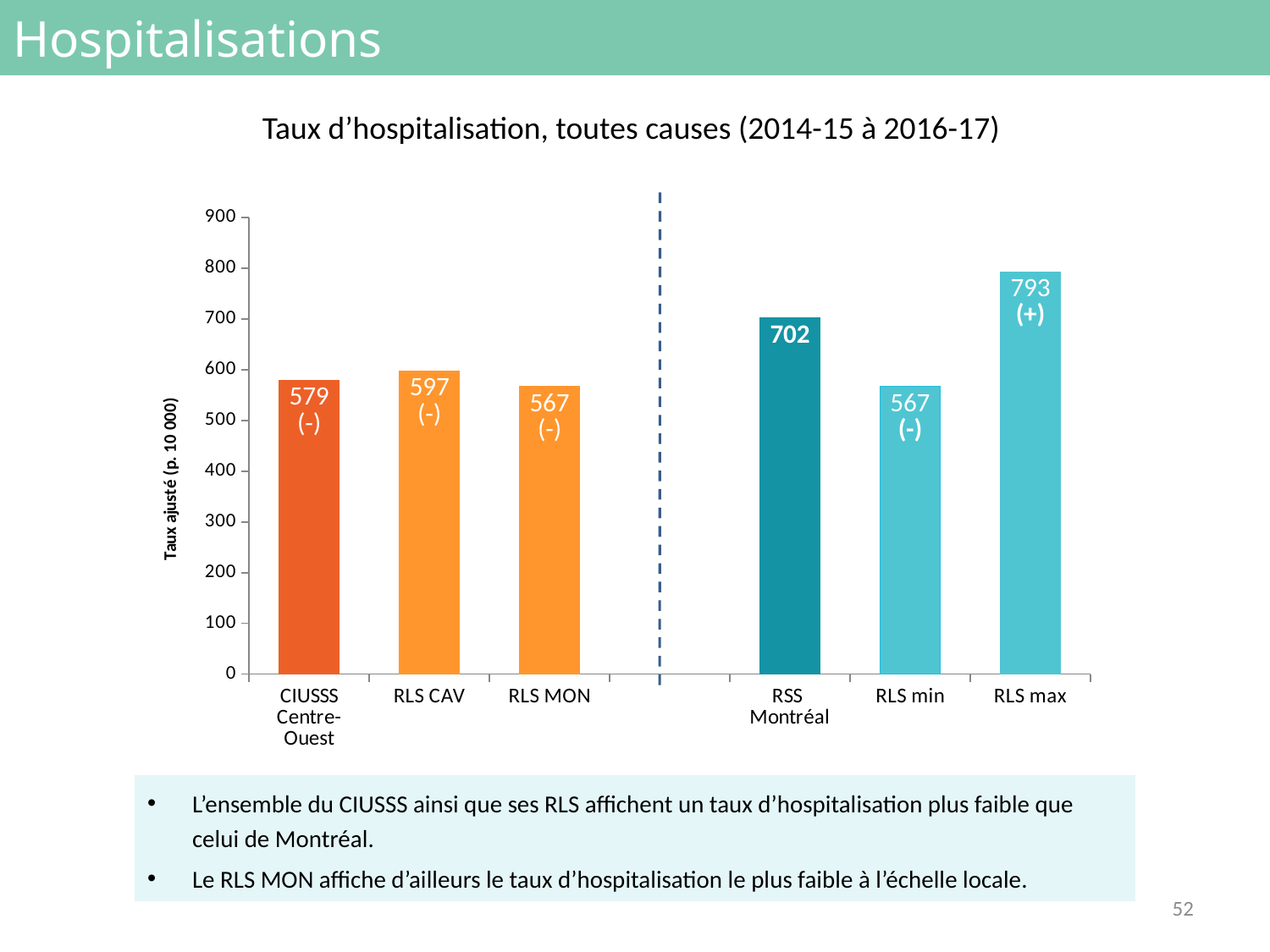
Which category has the highest value? RLS max What is the difference between the values for RLS max and RLS min? 226 What is the value for CIUSSS Centre-Ouest? 579 Which is larger, the value for RLS CAV or the value for RLS MON? RLS CAV What is the value for RLS CAV? 597 What is the difference between the values for RSS Montréal and CIUSSS Centre-Ouest? 123 What kind of chart is shown on the slide? Bar chart How many bars are shown in the chart? 6 What is the value for RSS Montréal? 702 What is the value for RLS max? 793 Among CIUSSS Centre-Ouest, RLS CAV and RLS MON, which has the lowest value? RLS MON Is the value for RSS Montréal greater or less than 600? greater